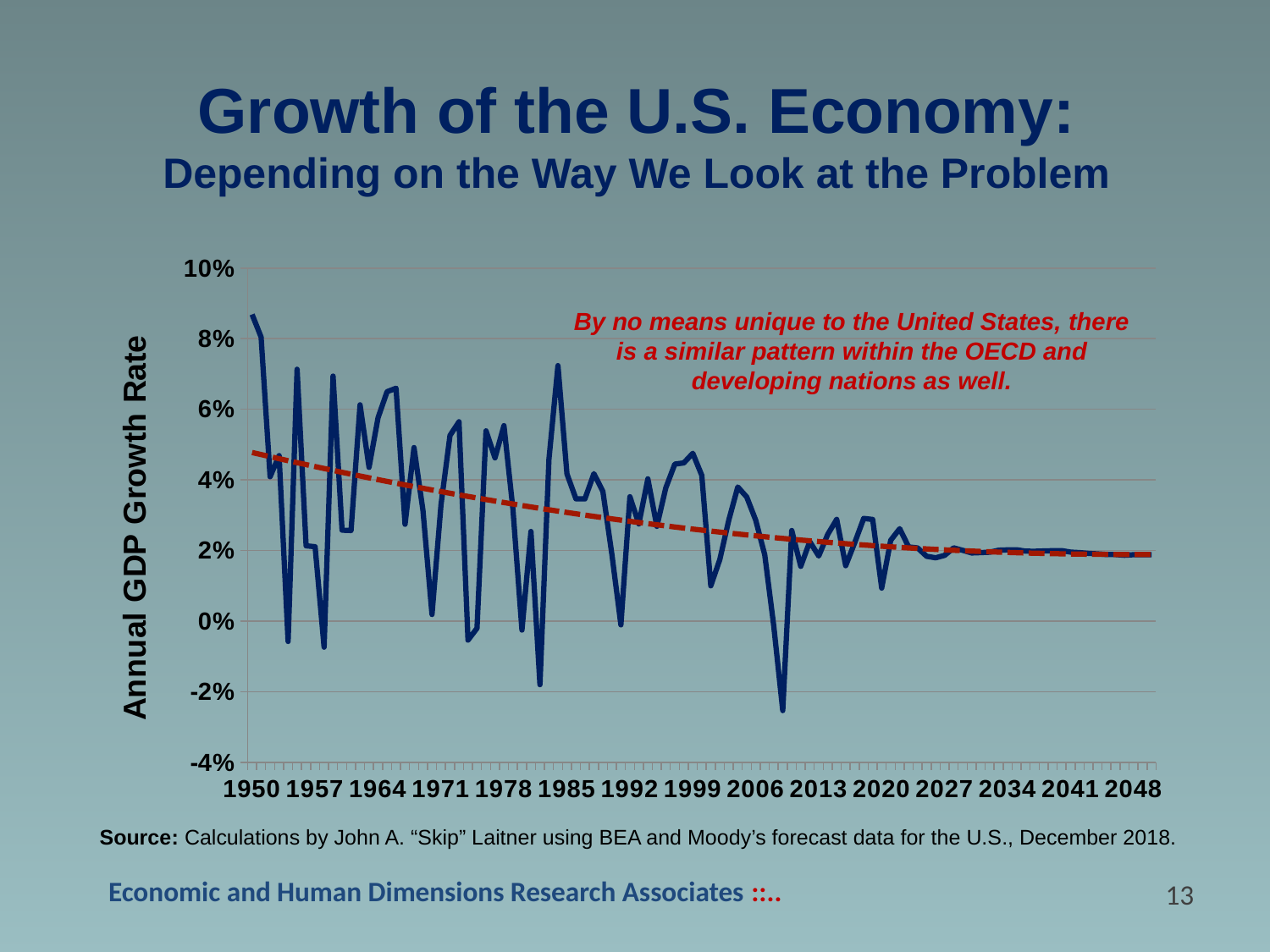
Is the dashed trend line's value at 1950 greater or less than 4%? greater What is the first year label on the x axis? 1950 What kind of chart is shown on the slide? line chart Is the lowest point of the growth-rate line, around 2009, greater or less than 0%? less In which year shown on the x axis does the growth-rate line reach its highest value? 1950 How many year labels are printed along the x axis? 15 Is the annual GDP growth rate plotted for 1950 greater or less than 8%? greater What is the highest value labelled on the vertical axis? 10% What is the label on the vertical axis of the chart? Annual GDP Growth Rate Which is larger: the growth rate plotted at 1950 or the growth rate plotted at 2048? 1950 Over the period shown on the x axis, does the dashed trend line rise or fall? fall